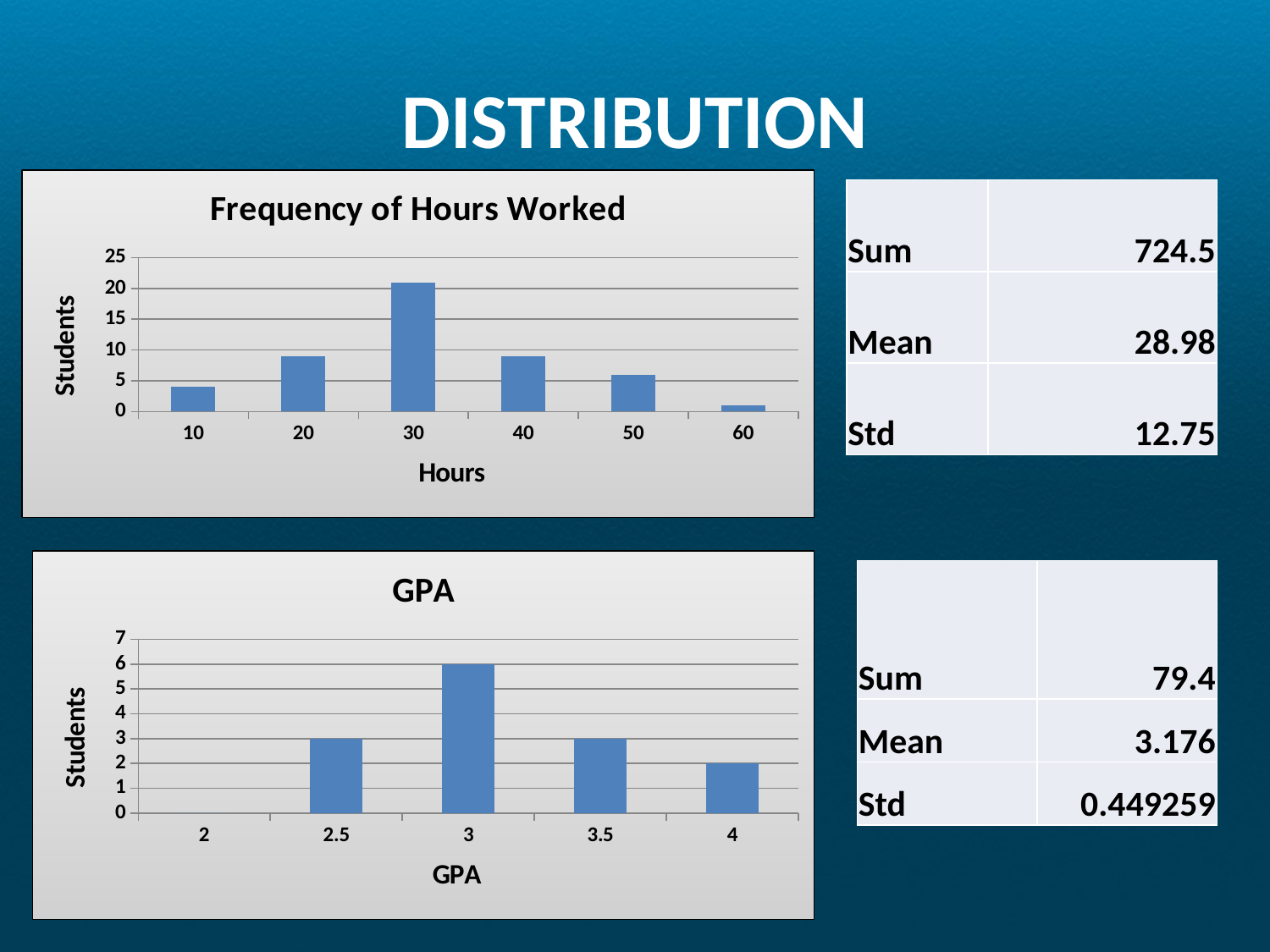
In the 'GPA' chart, how many students have a GPA of 4? 2 In the 'GPA' chart, how many students have a GPA of 3? 6 How many hours categories are shown in the 'Frequency of Hours Worked' chart? 6 In the 'Frequency of Hours Worked' chart, which hours category has the fewest students? 60 In the 'GPA' chart, which GPA category has the most students? 3 In the 'Frequency of Hours Worked' chart, which hours category has the most students? 30 What kind of chart is the 'Frequency of Hours Worked' chart? bar chart What is the y-axis title of the 'GPA' chart? Students In the 'GPA' chart, what is the difference between the number of students with a GPA of 3 and those with a GPA of 2.5? 3 In the 'Frequency of Hours Worked' chart, which has more students: 20 hours or 50 hours? 20 hours